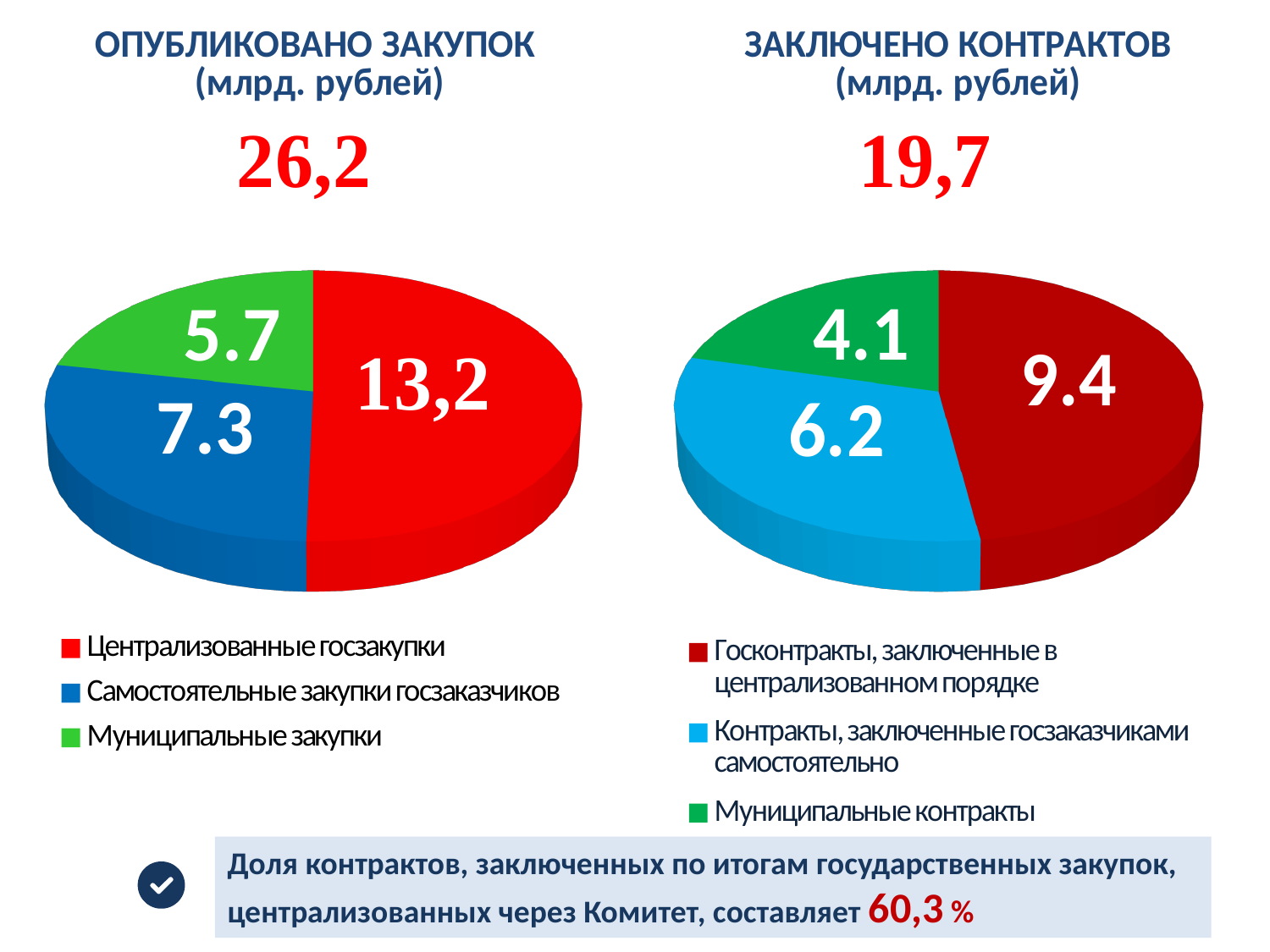
In the chart titled "ЗАКЛЮЧЕНО КОНТРАКТОВ (млрд. рублей)", which category has the largest slice? Госконтракты, заключенные в централизованном порядке In the chart titled "ЗАКЛЮЧЕНО КОНТРАКТОВ (млрд. рублей)", what is the value for "Контракты, заключенные госзаказчиками самостоятельно"? 6.2 In the chart titled "ЗАКЛЮЧЕНО КОНТРАКТОВ (млрд. рублей)", which is larger: "Контракты, заключенные госзаказчиками самостоятельно" or "Муниципальные контракты"? Контракты, заключенные госзаказчиками самостоятельно In the chart titled "ОПУБЛИКОВАНО ЗАКУПОК (млрд. рублей)", what is the difference between "Централизованные госзакупки" and "Самостоятельные закупки госзаказчиков"? 5.9 In the chart titled "ОПУБЛИКОВАНО ЗАКУПОК (млрд. рублей)", which category has the smallest slice? Муниципальные закупки In the chart titled "ОПУБЛИКОВАНО ЗАКУПОК (млрд. рублей)", what is the value for "Муниципальные закупки"? 5.7 How many slices does the chart titled "ОПУБЛИКОВАНО ЗАКУПОК (млрд. рублей)" have? 3 In the chart titled "ОПУБЛИКОВАНО ЗАКУПОК (млрд. рублей)", what colour is the slice for "Самостоятельные закупки госзаказчиков"? Blue What total value is shown above the chart titled "ЗАКЛЮЧЕНО КОНТРАКТОВ (млрд. рублей)"? 19,7 What kind of chart is the chart titled "ЗАКЛЮЧЕНО КОНТРАКТОВ (млрд. рублей)"? Pie chart In the chart titled "ЗАКЛЮЧЕНО КОНТРАКТОВ (млрд. рублей)", what is the difference between "Госконтракты, заключенные в централизованном порядке" and "Муниципальные контракты"? 5.3 In the chart titled "ОПУБЛИКОВАНО ЗАКУПОК (млрд. рублей)", what is the value for "Централизованные госзакупки"? 13,2